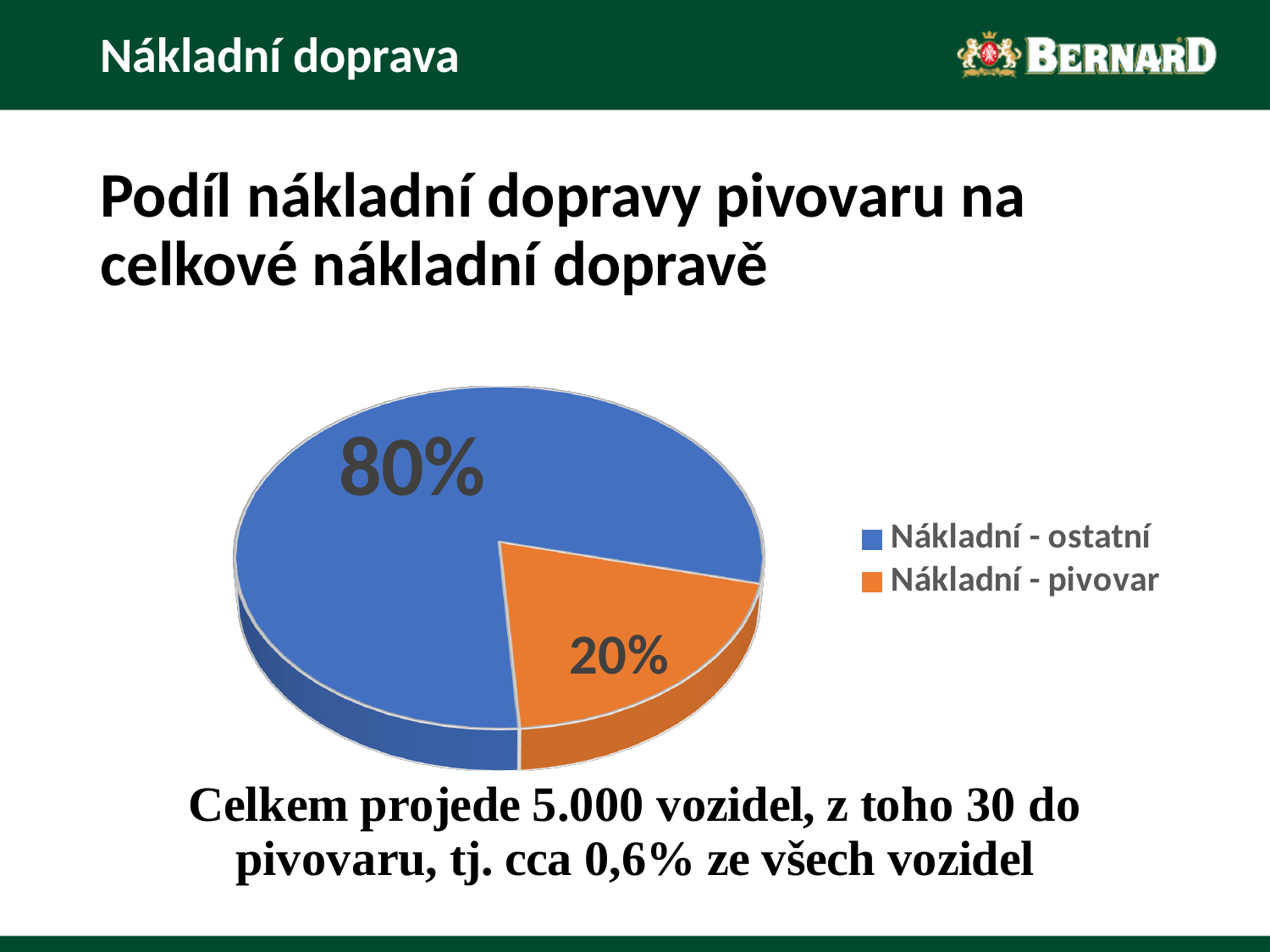
What kind of chart is shown on the slide? pie chart What share of the pie does "Nákladní - pivovar" represent? 20% What colour is the "Nákladní - pivovar" slice? orange Which slice of the pie is the largest? Nákladní - ostatní How many slices does the pie chart have? 2 Which is larger, the "Nákladní - ostatní" slice or the "Nákladní - pivovar" slice? Nákladní - ostatní How many entries does the legend list? 2 Which slice of the pie is the smallest? Nákladní - pivovar What share of the pie does "Nákladní - ostatní" represent? 80% What colour is the "Nákladní - ostatní" slice? blue What is the difference in percentage points between the "Nákladní - ostatní" and "Nákladní - pivovar" slices? 60 percentage points